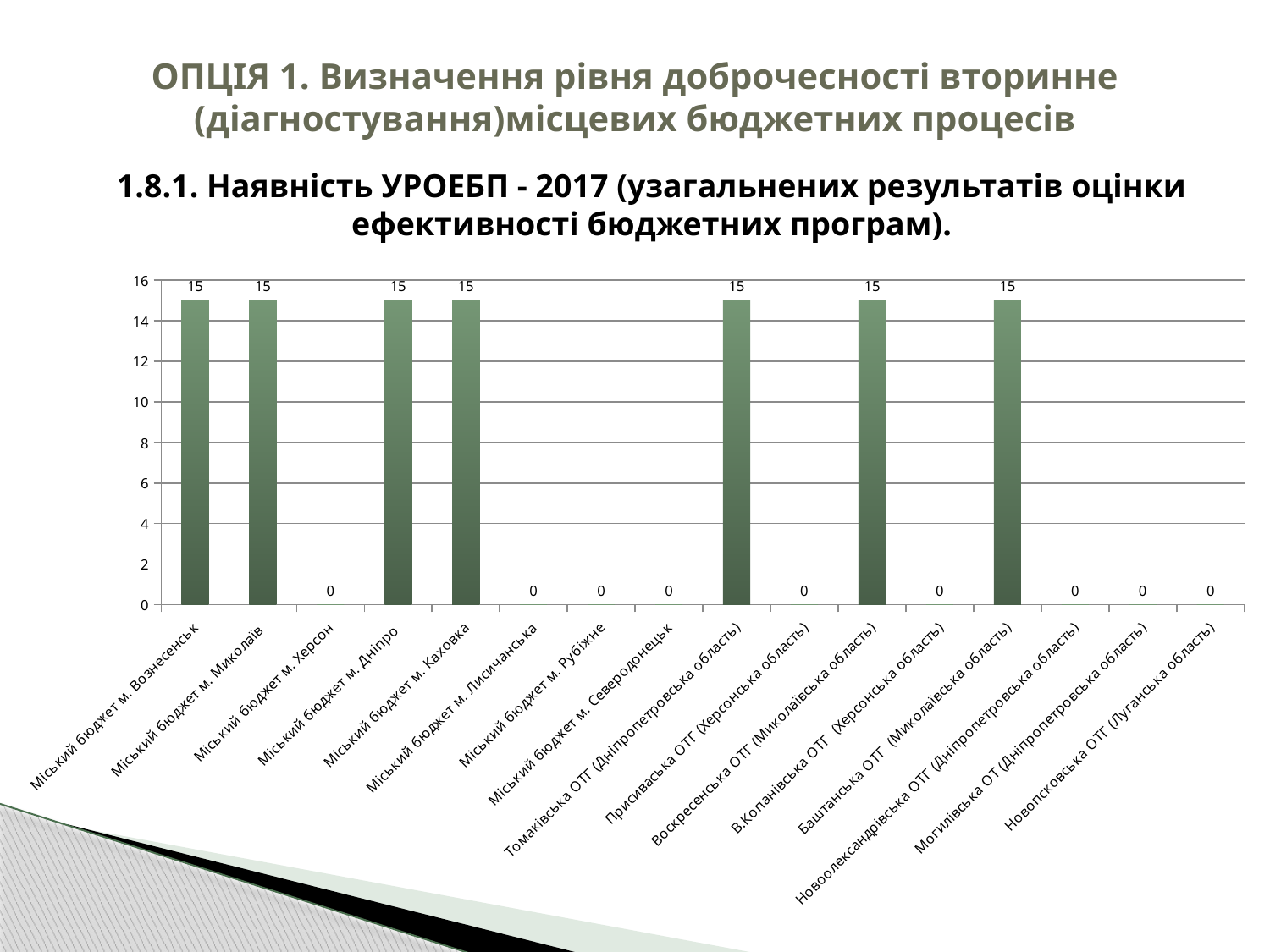
What is the difference between the values for Міський бюджет м. Дніпро and Міський бюджет м. Рубіжне? 15 What kind of chart is shown on the slide? bar chart What is the value for Новопсковська ОТГ (Луганська область)? 0 What is the value for Присиваська ОТГ (Херсонська область)? 0 What is the value for Баштанська ОТГ (Миколаївська область)? 15 What is the value for Томаківська ОТГ (Дніпропетровська область)? 15 What is the value for Міський бюджет м. Херсон? 0 Is the value for Міський бюджет м. Каховка greater or less than 10? greater How many categories are shown on the x axis of the chart? 16 How many categories have a value of 15? 7 Which has the larger value, Воскресенська ОТГ (Миколаївська область) or В.Копанівська ОТГ (Херсонська область)? Воскресенська ОТГ (Миколаївська область) What is the value for Міський бюджет м. Вознесенськ? 15